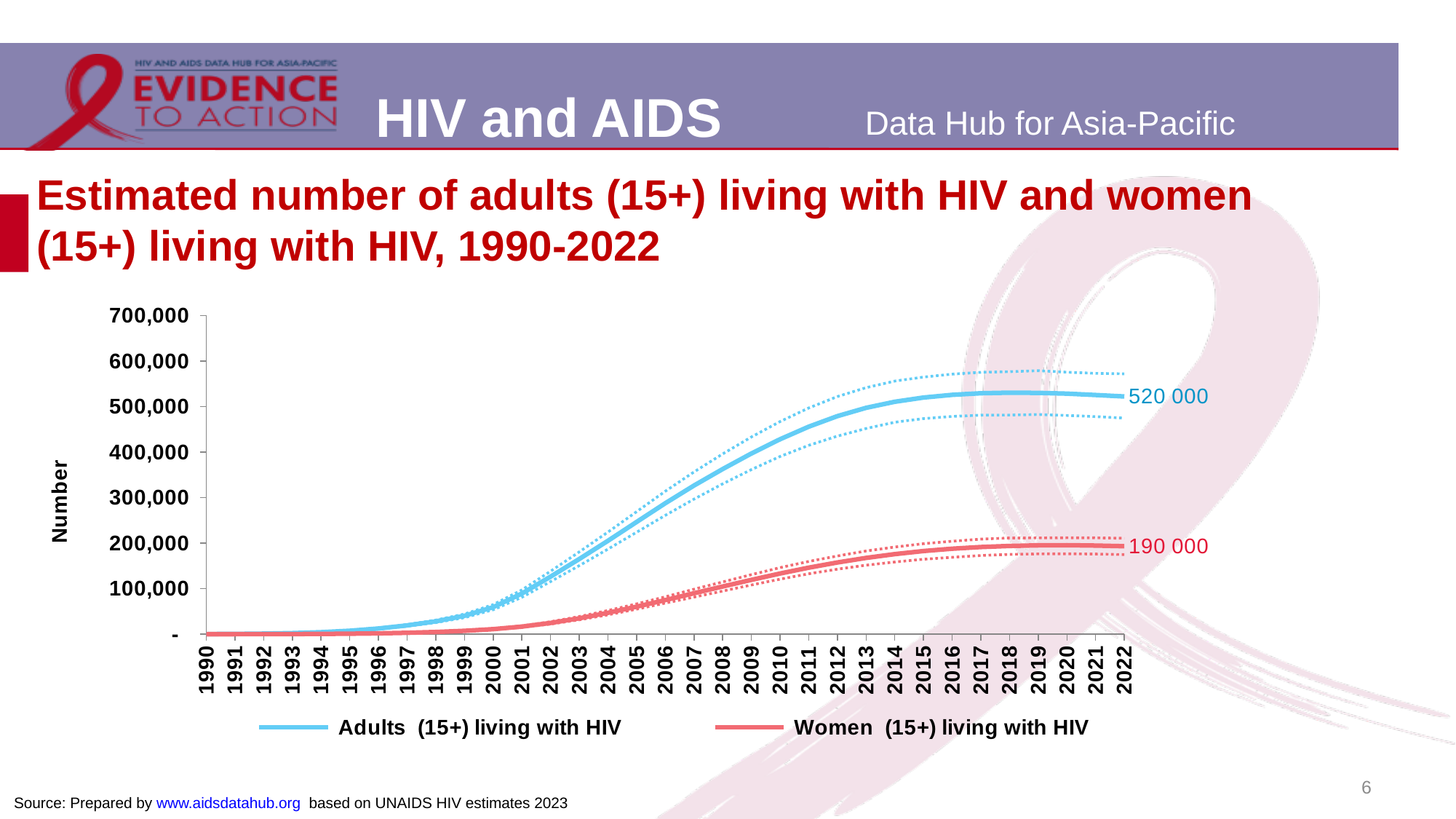
Does the number of adults (15+) living with HIV generally rise or fall from 1990 to 2022? Rise In 2022, which series has the larger value: adults (15+) living with HIV or women (15+) living with HIV? Adults (15+) living with HIV What is the difference between the number of adults (15+) and women (15+) living with HIV in 2022? 330 000 What is the estimated number of women (15+) living with HIV in 2022? 190 000 Is the value for adults (15+) living with HIV in 2000 greater or less than 100,000? less Is the value for adults (15+) living with HIV in 2010 greater or less than 300,000? greater What colour is the line for adults (15+) living with HIV? Blue What kind of chart is shown on the slide? Line chart How many years are shown on the x axis of the chart? 33 Is the value for women (15+) living with HIV in 2010 greater or less than 100,000? greater How many series does the chart legend list? 2 What is the estimated number of adults (15+) living with HIV in 2022? 520 000